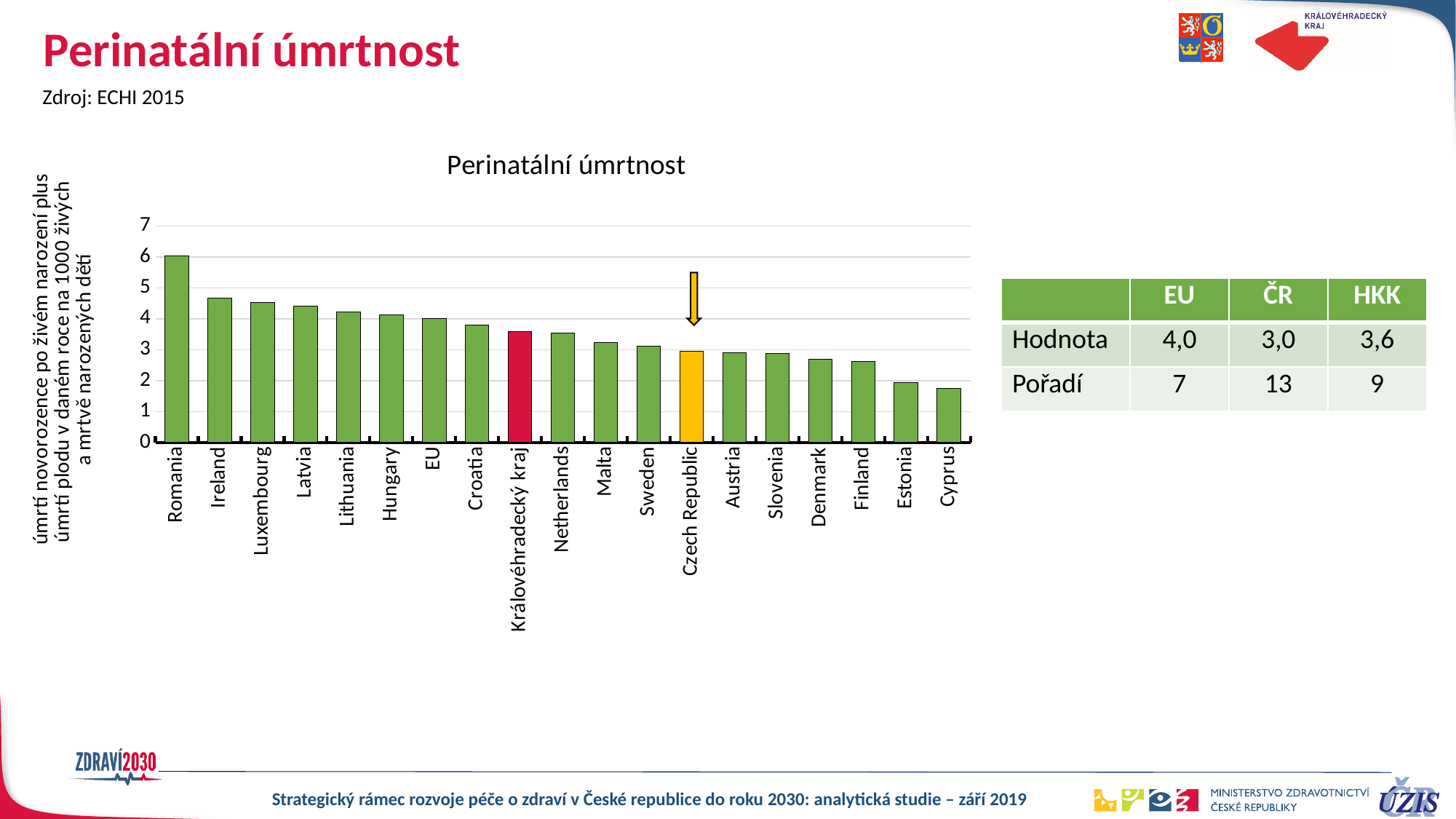
Do the values rise or fall from left to right along the x axis? fall Which country has the highest perinatal mortality in the chart? Romania Which is larger, the value for Romania or the value for Ireland? Romania How many bars are plotted in the chart? 19 What is the perinatal mortality value for the Czech Republic (ČR), as given in the table? 3,0 Which country has the lowest perinatal mortality in the chart? Cyprus Is the value for Romania greater or less than 5? greater What is the perinatal mortality value for the EU, as given in the table? 4,0 Is the value for Denmark greater or less than 3? less What type of chart is shown on the slide? bar chart What is the difference between the EU value and the ČR value in the table? 1,0 What is the perinatal mortality value for Královéhradecký kraj (HKK), as given in the table? 3,6